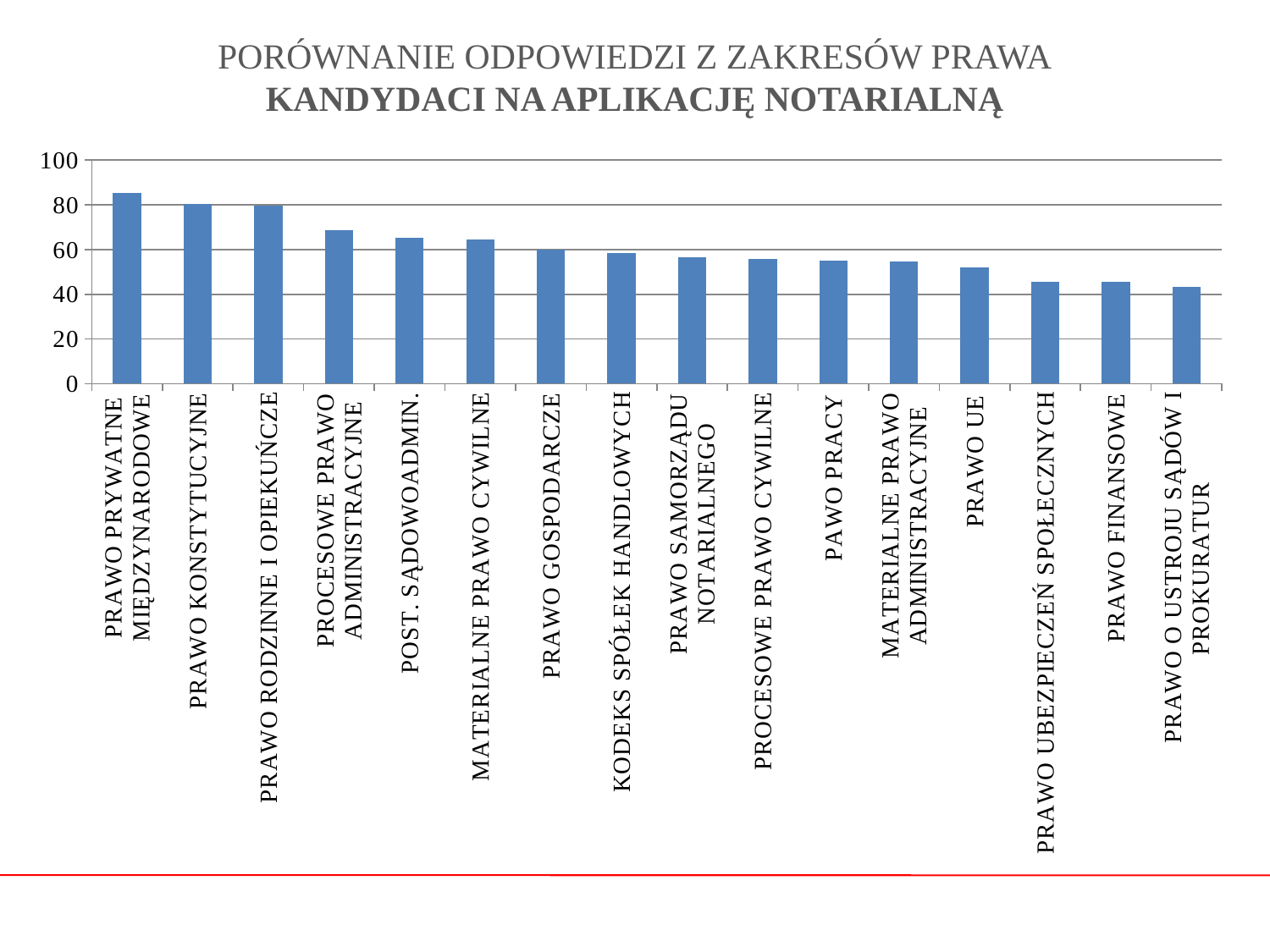
Which area of law has the highest value in the chart? PRAWO PRYWATNE MIĘDZYNARODOWE Is the value for PROCESOWE PRAWO ADMINISTRACYJNE greater or less than 60? greater Which area of law has the lowest value in the chart? PRAWO O USTROJU SĄDÓW I PROKURATUR Is the value for PRAWO O USTROJU SĄDÓW I PROKURATUR greater or less than 60? less Is the value for PRAWO UE greater or less than 60? less Which has a larger value, PRAWO KONSTYTUCYJNE or PRAWO UE? PRAWO KONSTYTUCYJNE How many categories (areas of law) are plotted in the chart? 16 What kind of chart is shown on the slide? bar chart What is the bold second line of the chart title? KANDYDACI NA APLIKACJĘ NOTARIALNĄ Do the values rise or fall moving from left to right along the x axis? fall